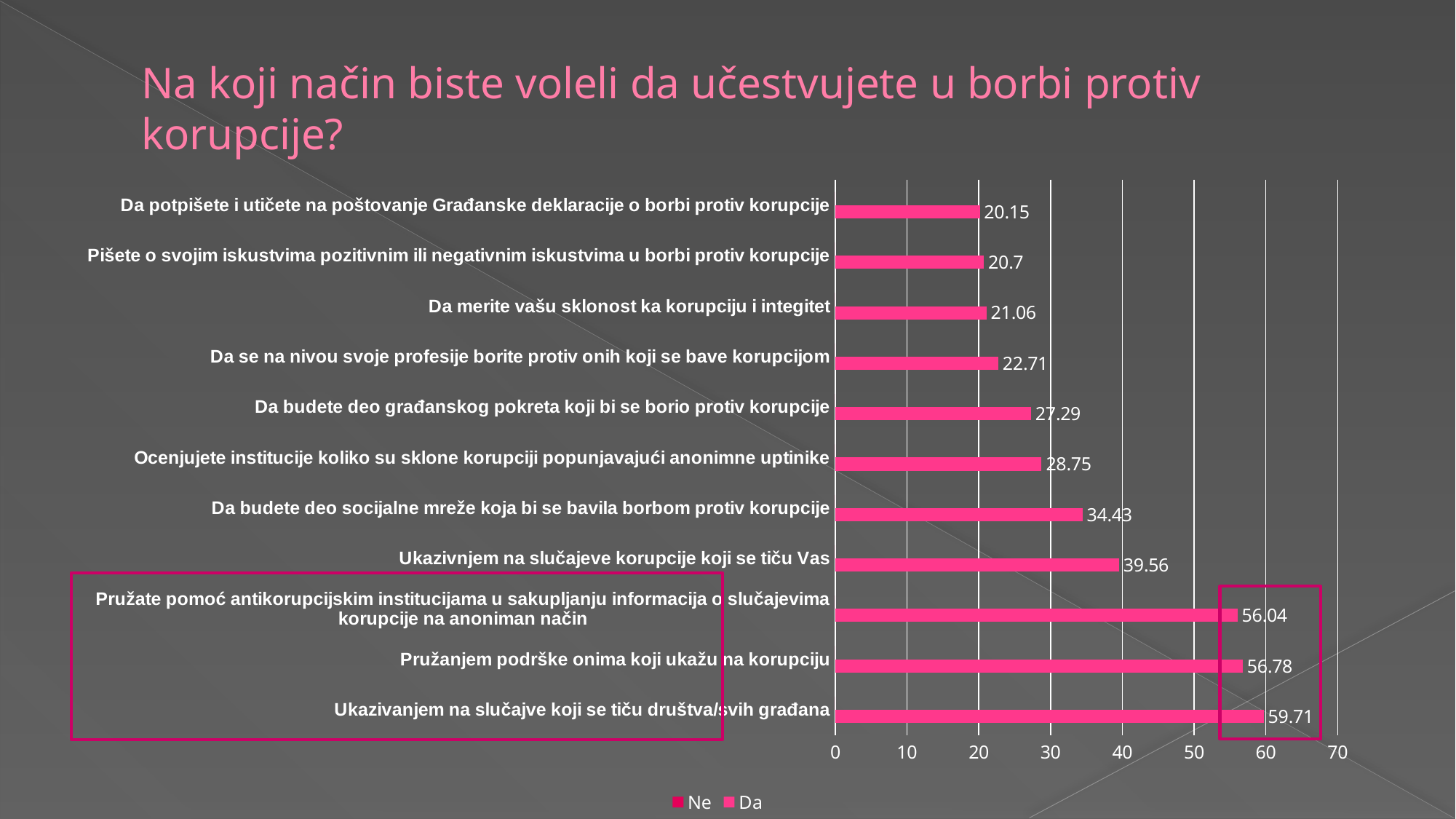
What is the value for "Pružanjem podrške onima koji ukažu na korupciju"? 56.78 How many series does the legend list? 2 Which category has the lowest value? Da potpišete i utičete na poštovanje Građanske deklaracije o borbi protiv korupcije What kind of chart is shown on the slide? Bar chart Which category has the highest value? Ukazivanjem na slučajve koji se tiču društva/svih građana What is the value for "Da merite vašu sklonost ka korupciju i integitet"? 21.06 Which is larger: the value for "Ocenjujete institucije koliko su sklone korupciji popunjavajući anonimne uptinike" or for "Da budete deo građanskog pokreta koji bi se borio protiv korupcije"? Ocenjujete institucije koliko su sklone korupciji popunjavajući anonimne uptinike How many categories are shown in the chart? 11 What is the difference between the values for "Ukazivnjem na slučajeve korupcije koji se tiču Vas" and "Da budete deo socijalne mreže koja bi se bavila borbom protiv korupcije"? 5.13 What is the value for "Da budete deo socijalne mreže koja bi se bavila borbom protiv korupcije"? 34.43 What is the difference between the highest value (59.71) and the lowest value (20.15)? 39.56 Is the value for "Pružate pomoć antikorupcijskim institucijama u sakupljanju informacija o slučajevima korupcije na anoniman način" greater or less than 50? greater